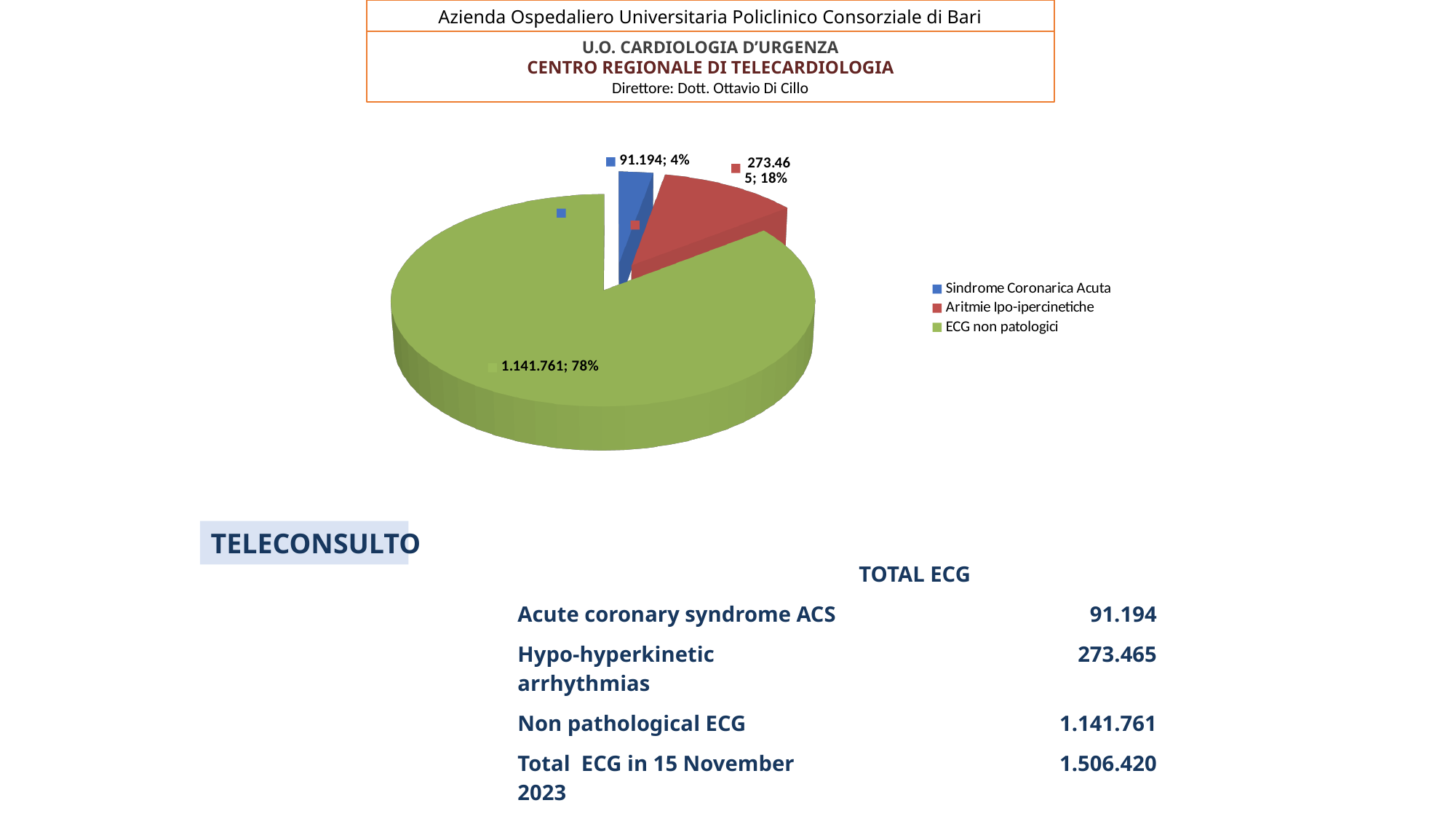
Which colour represents Aritmie Ipo-ipercinetiche in the pie chart? red Which category has the smallest slice of the pie? Sindrome Coronarica Acuta How many slices does the pie chart have? 3 What percentage share of the pie does Sindrome Coronarica Acuta represent? 4% What percentage share of the pie does ECG non patologici represent? 78% What value is shown for the ECG non patologici slice? 1.141.761 Which category has the largest slice of the pie? ECG non patologici What value is shown for the Sindrome Coronarica Acuta slice? 91.194 What kind of chart is shown on the slide? pie chart What percentage share of the pie does Aritmie Ipo-ipercinetiche represent? 18% What value is shown for the Aritmie Ipo-ipercinetiche slice? 273.465 How many entries does the legend of the pie chart list? 3